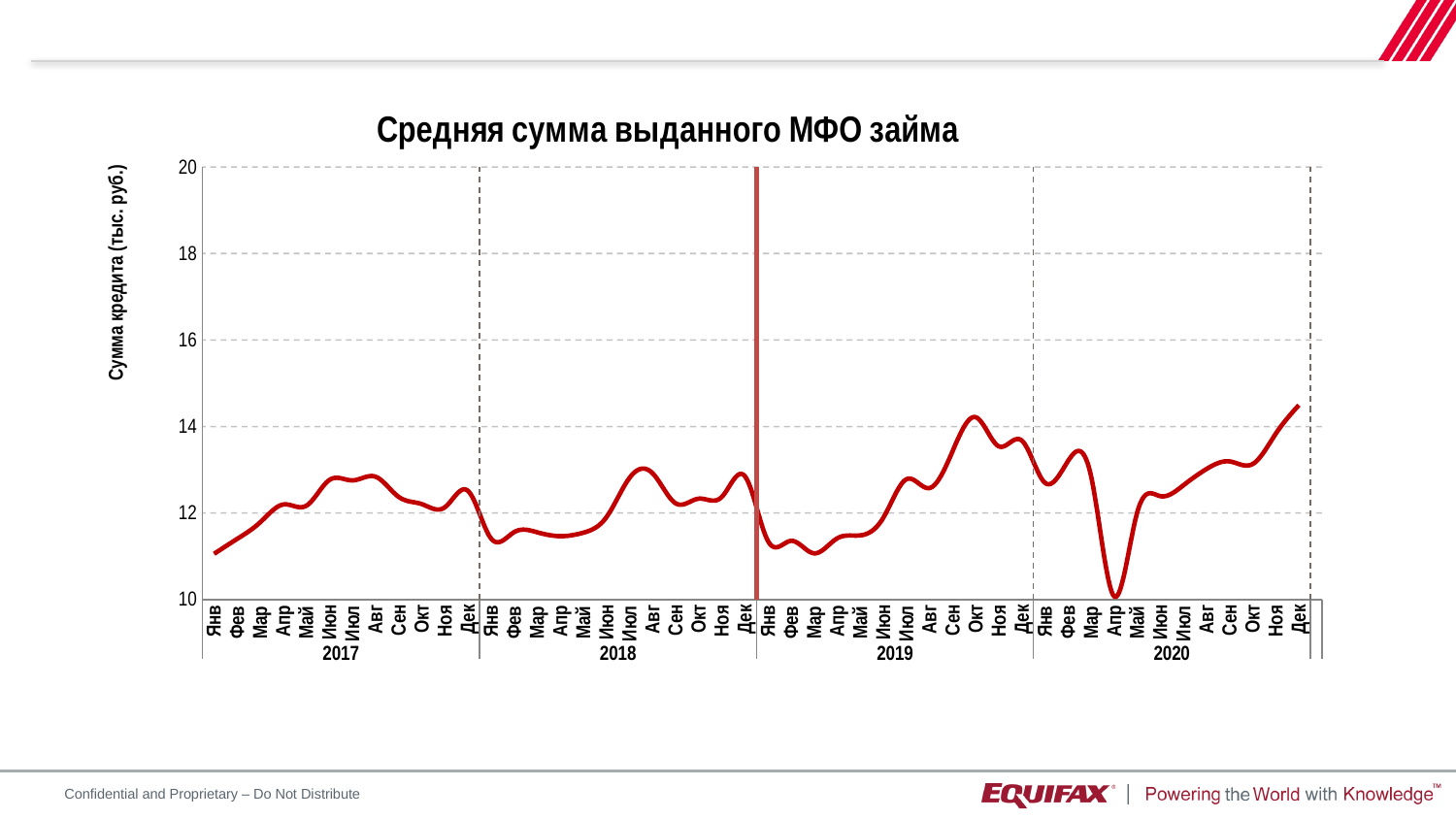
Is the value for Дек 2020 greater or less than 14? greater Does the line rise or fall from Апр 2020 to Дек 2020? rise Is the value for Янв 2017 greater or less than 12? less How many years are covered on the x axis of the chart? 4 What is the title of the chart? Средняя сумма выданного МФО займа Is the value for Июл 2018 greater or less than 12? greater What is the label of the vertical axis? Сумма кредита (тыс. руб.) Which month shows the lowest value on the chart? Апр 2020 Which is larger, the value for Окт 2019 or the value for Фев 2019? Окт 2019 What kind of chart is shown on the slide? line chart